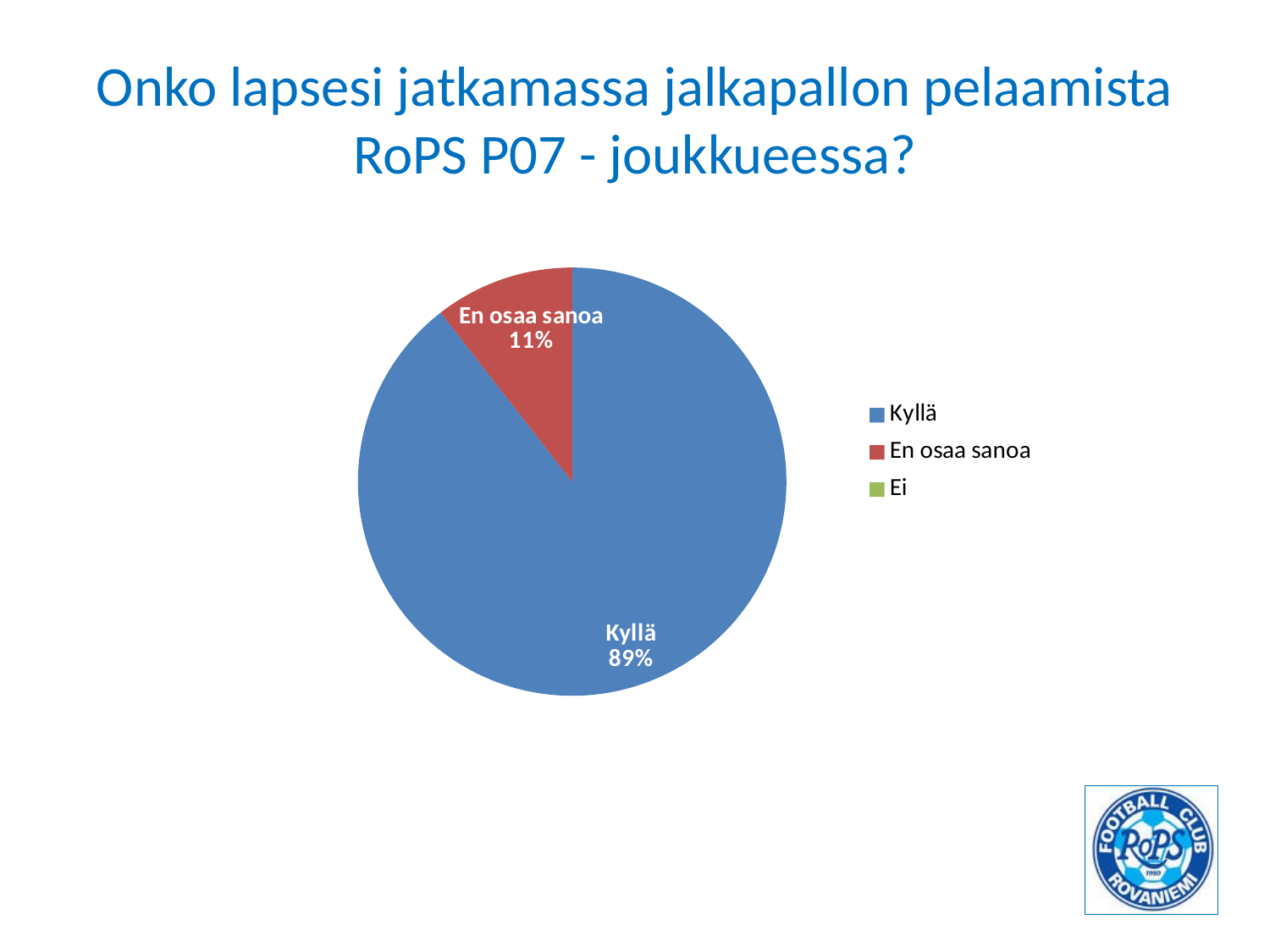
What kind of chart is shown on the slide? pie chart Which legend entry has no visible slice in the pie? Ei Is the share for Kyllä greater or less than 50%? greater What is the difference in percentage points between the Kyllä and En osaa sanoa slices? 78 How many entries does the legend list? 3 What share of the pie does En osaa sanoa represent? 11% What colour is the Kyllä slice? blue Which category has the largest slice of the pie? Kyllä What share of the pie does Kyllä represent? 89% Which of the two labelled slices is larger, Kyllä or En osaa sanoa? Kyllä